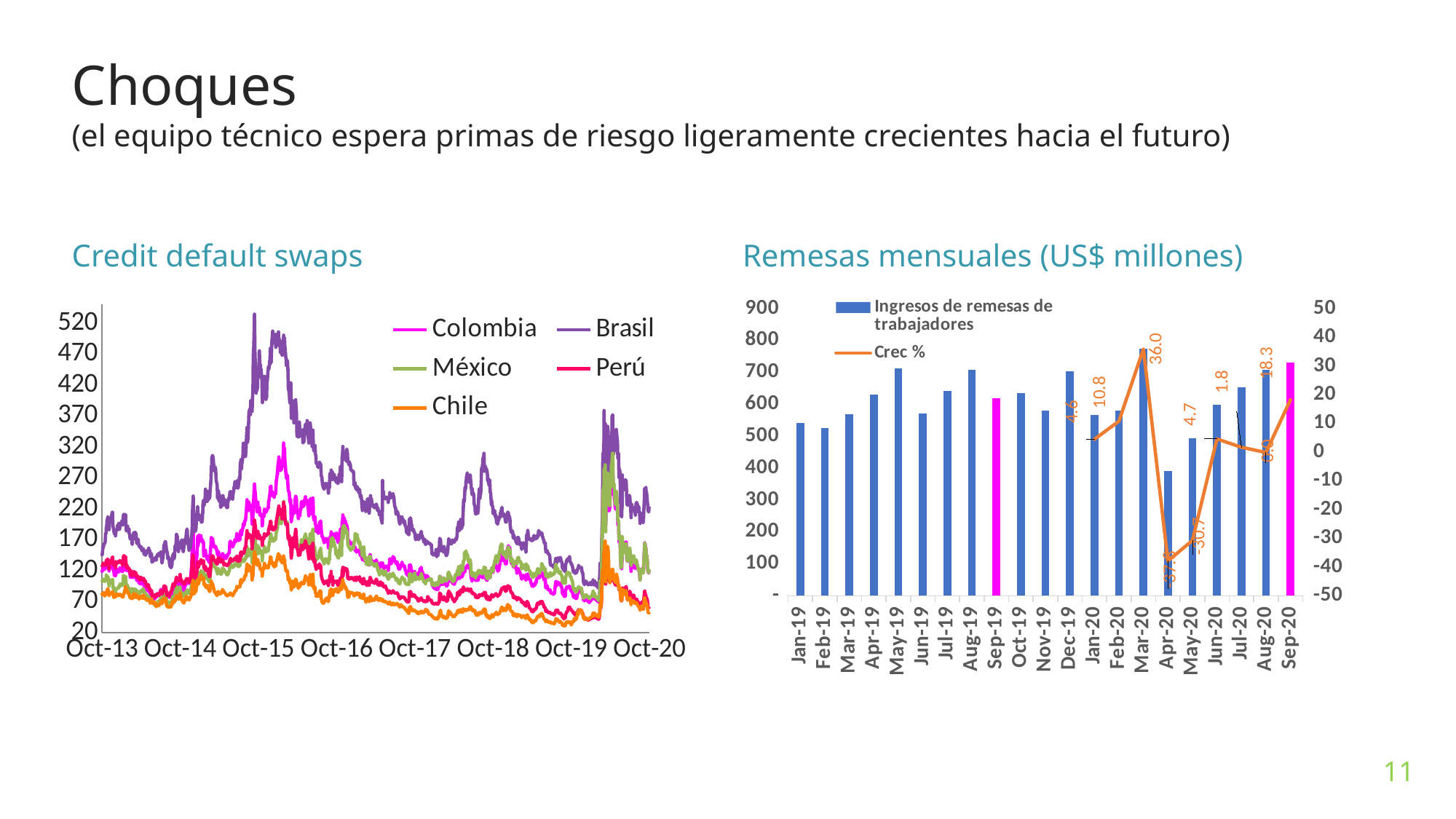
In the 'Remesas mensuales (US$ millones)' chart, which month has the shortest bar? Apr-20 In the 'Remesas mensuales (US$ millones)' chart, how many months are shown on the x axis? 21 What kind of chart is the 'Credit default swaps' chart? Line chart In the 'Remesas mensuales (US$ millones)' chart, what is the highest value shown for Crec %? 36.0 In the 'Credit default swaps' chart, what are the first and last labels on the x axis? Oct-13 and Oct-20 How many series does the legend of the 'Credit default swaps' chart list? 5 In the 'Credit default swaps' chart, which country's line is generally the lowest? Chile In the 'Remesas mensuales (US$ millones)' chart, which month has the tallest bar? Mar-20 In the 'Remesas mensuales (US$ millones)' chart, what are the two legend entries? Ingresos de remesas de trabajadores and Crec % In the 'Remesas mensuales (US$ millones)' chart, is the bar for Apr-20 greater or less than 500? less In the 'Credit default swaps' chart, which country's line reaches the highest value? Brasil In the 'Remesas mensuales (US$ millones)' chart, is the bar for May-19 greater or less than 600? greater